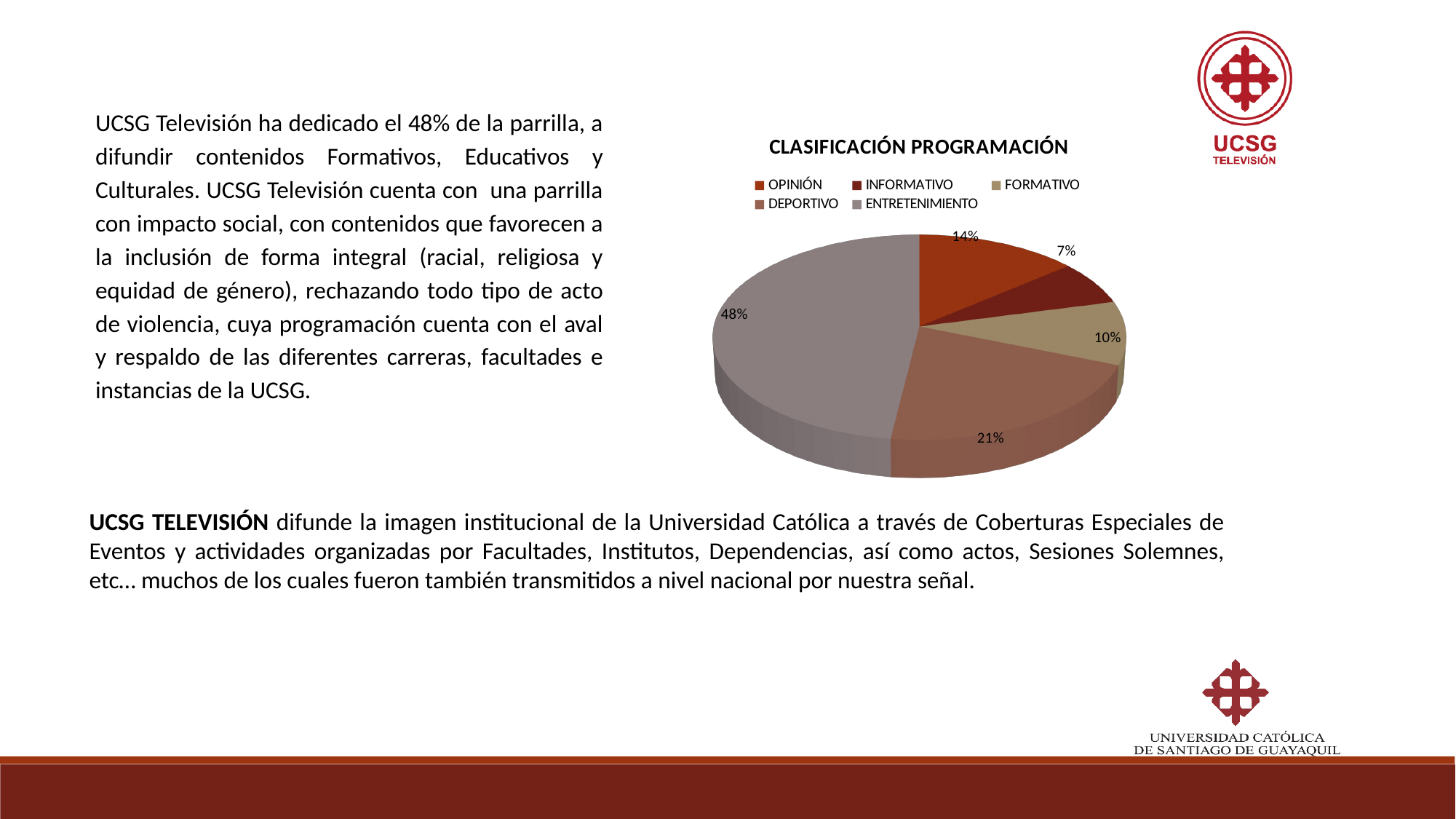
Which category has the smallest share of the pie? INFORMATIVO What share of the pie does OPINIÓN have? 14% What is the title of the chart? CLASIFICACIÓN PROGRAMACIÓN What is the difference between the shares of ENTRETENIMIENTO and DEPORTIVO? 27% What share of the pie does FORMATIVO have? 10% Which category has the largest share of the pie? ENTRETENIMIENTO What share of the pie does ENTRETENIMIENTO have? 48% What kind of chart is shown on the slide? pie chart Which has a larger share, OPINIÓN or FORMATIVO? OPINIÓN How many categories does the pie chart show? 5